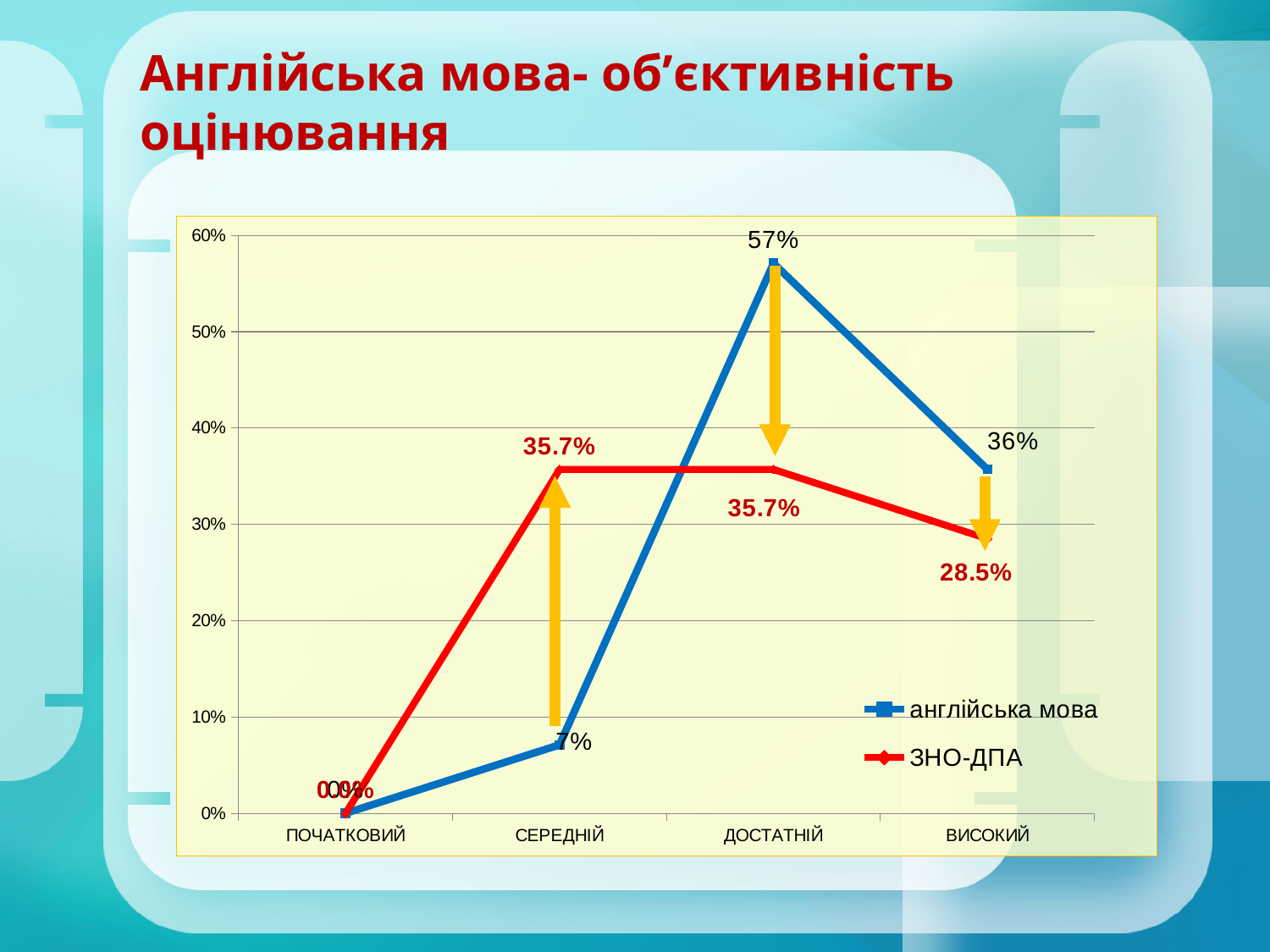
How many series does the legend list? 2 What is the value of the англійська мова series for ДОСТАТНІЙ? 57% Which series is drawn in red? ЗНО-ДПА What is the difference between the англійська мова and ЗНО-ДПА values for ДОСТАТНІЙ? 21.3% For СЕРЕДНІЙ, which series has the larger value, англійська мова or ЗНО-ДПА? ЗНО-ДПА What type of chart is shown on the slide? line chart For which category is the англійська мова series highest? ДОСТАТНІЙ What is the value of the ЗНО-ДПА series for СЕРЕДНІЙ? 35.7% What is the value of the англійська мова series for СЕРЕДНІЙ? 7% What is the value of the ЗНО-ДПА series for ВИСОКИЙ? 28.5% How many categories are shown on the x axis? 4 For which category is the ЗНО-ДПА series lowest? ПОЧАТКОВИЙ